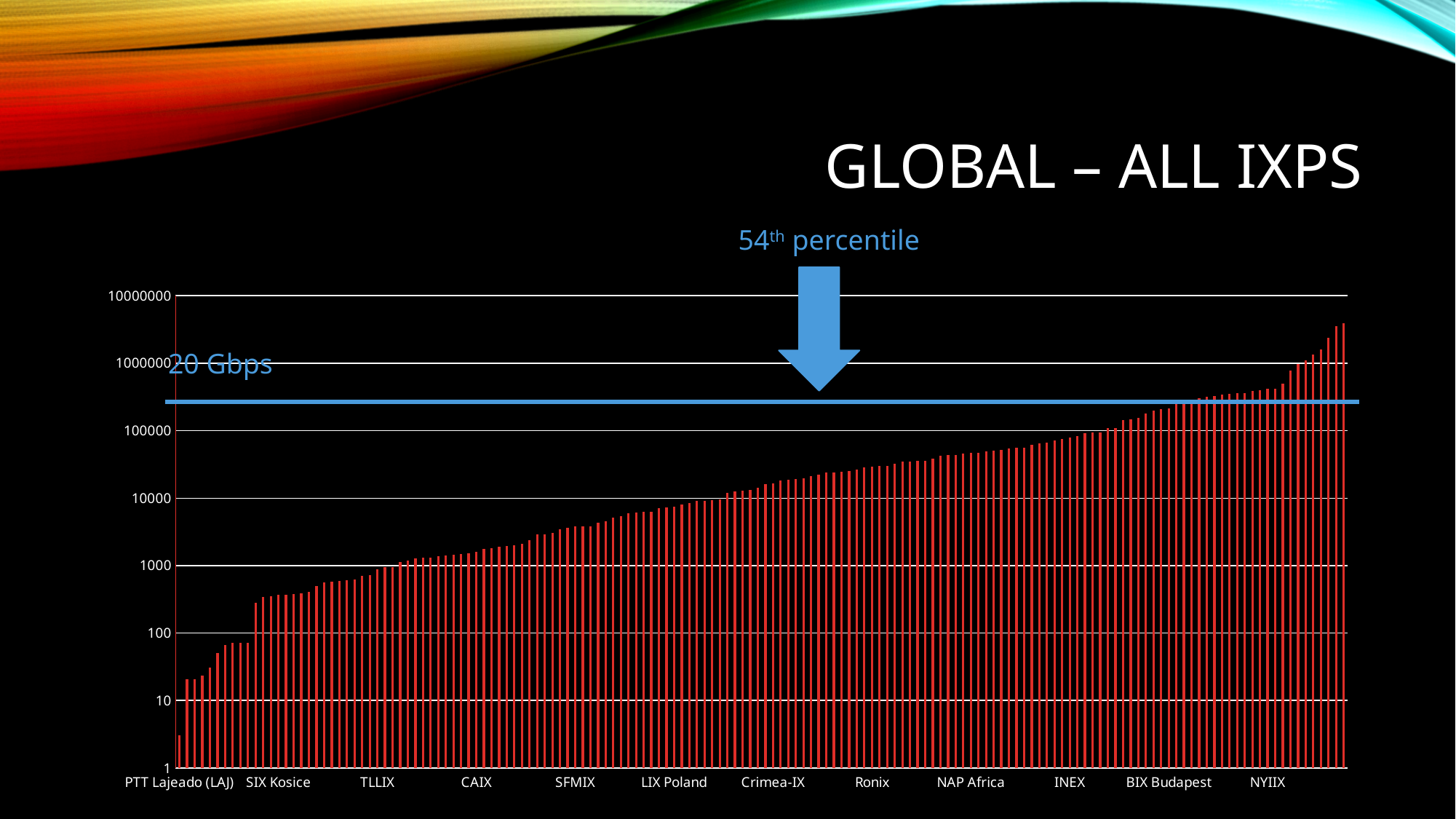
Is the value for PTT Lajeado (LAJ) greater or less than 10? less Which has the larger value, NYIIX or SIX Kosice? NYIIX Is the value for SIX Kosice greater or less than 100? greater What value does the horizontal blue line across the chart represent? 20 Gbps Is the value for Crimea-IX greater or less than 10000? greater What kind of chart is shown on the slide? bar chart What is the title of the slide's chart? GLOBAL – ALL IXPS Do the bar values rise or fall from left to right along the x axis? rise